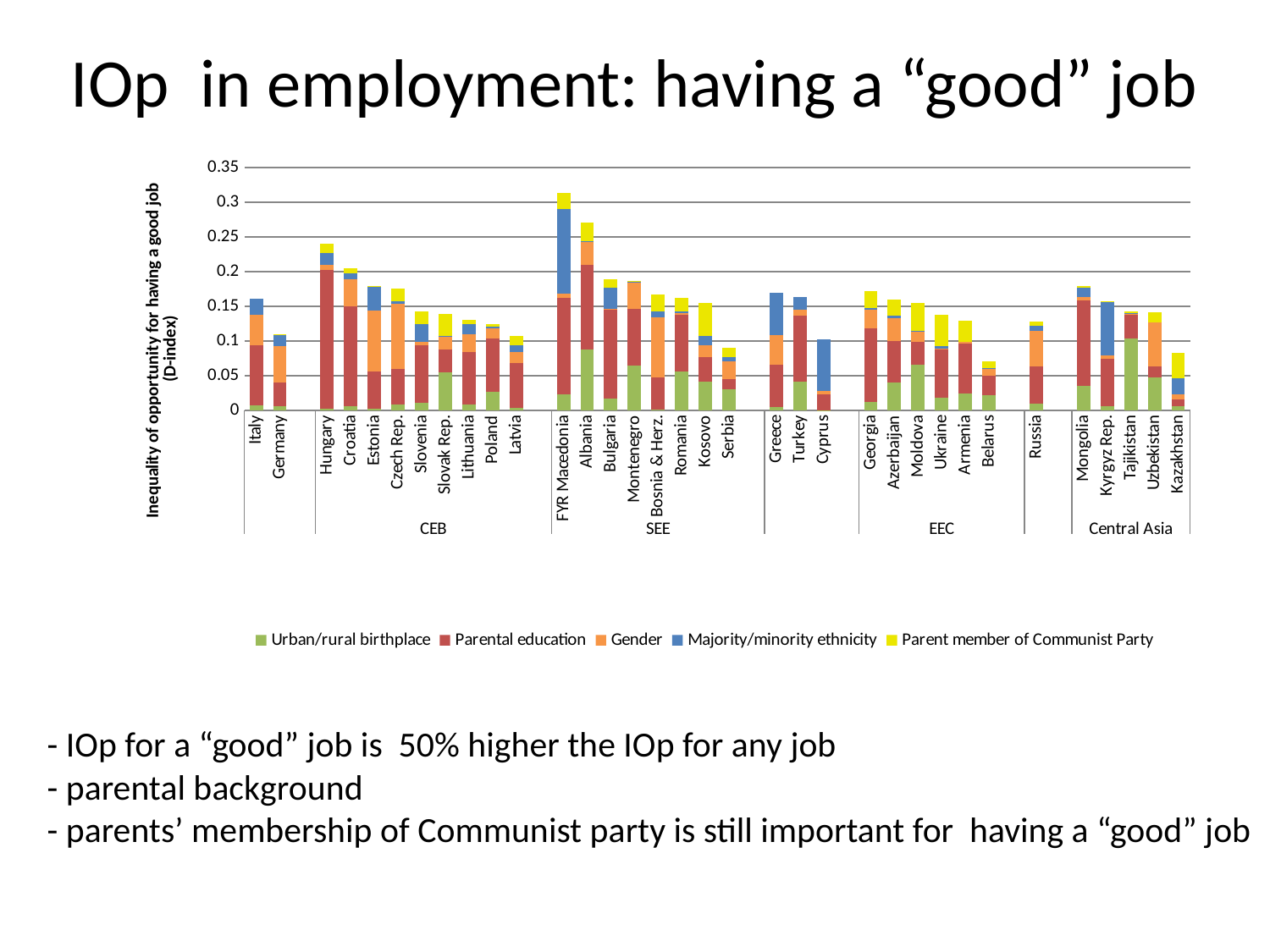
Which legend entry is shown in yellow? Parent member of Communist Party What kind of chart is shown on the slide? Stacked bar chart Within the CEB group, which country has the lowest total bar? Latvia How many countries are shown in the CEB group? 9 Is the total value for Hungary greater or less than 0.2? greater Which country has the highest inequality of opportunity for having a good job? FYR Macedonia Is the total value for Belarus greater or less than 0.1? less Within the SEE group, which country has the lowest total bar? Serbia Which has the larger total bar, Albania or Bulgaria? Albania How many series does the legend list? 5 Which has the larger total bar, Greece or Cyprus? Greece Is the total value for FYR Macedonia greater or less than 0.3? greater